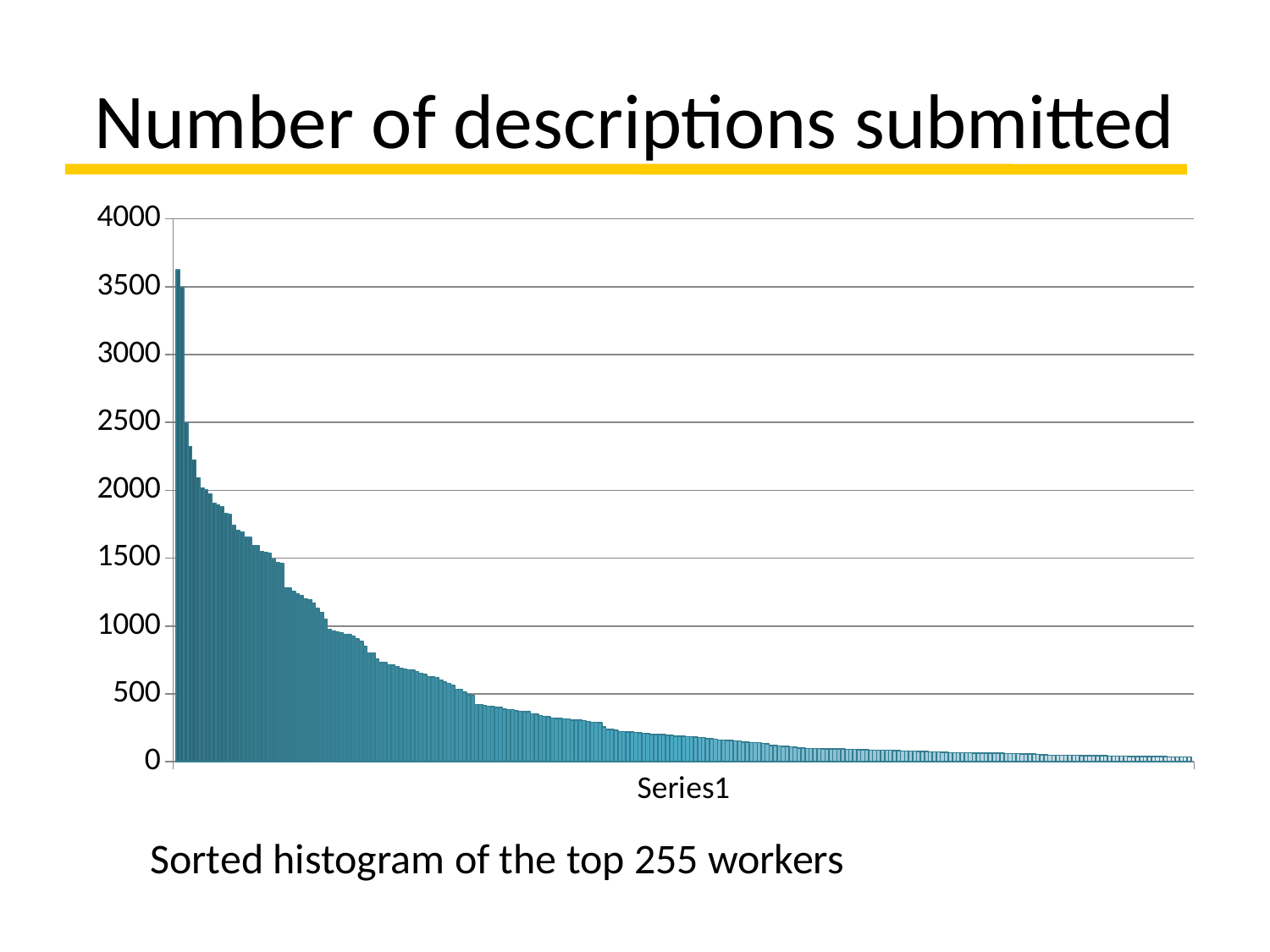
Is the value of the tallest (leftmost) bar greater or less than 3500? greater Is the value of the second bar from the left greater or less than 3000? greater What is the title of the slide's chart? Number of descriptions submitted Which is larger, the value of the leftmost bar or the value of the rightmost bar? leftmost bar Which bar has the highest value, the leftmost or the rightmost? leftmost What kind of chart is shown on the slide? bar chart Is the value of the tallest bar greater or less than 4000? less According to the caption, how many workers are represented by the bars in the chart? 255 Do the bar values rise or fall from left to right along the x axis? fall Which bar has the lowest value, the leftmost or the rightmost? rightmost What is the highest value shown on the vertical axis? 4000